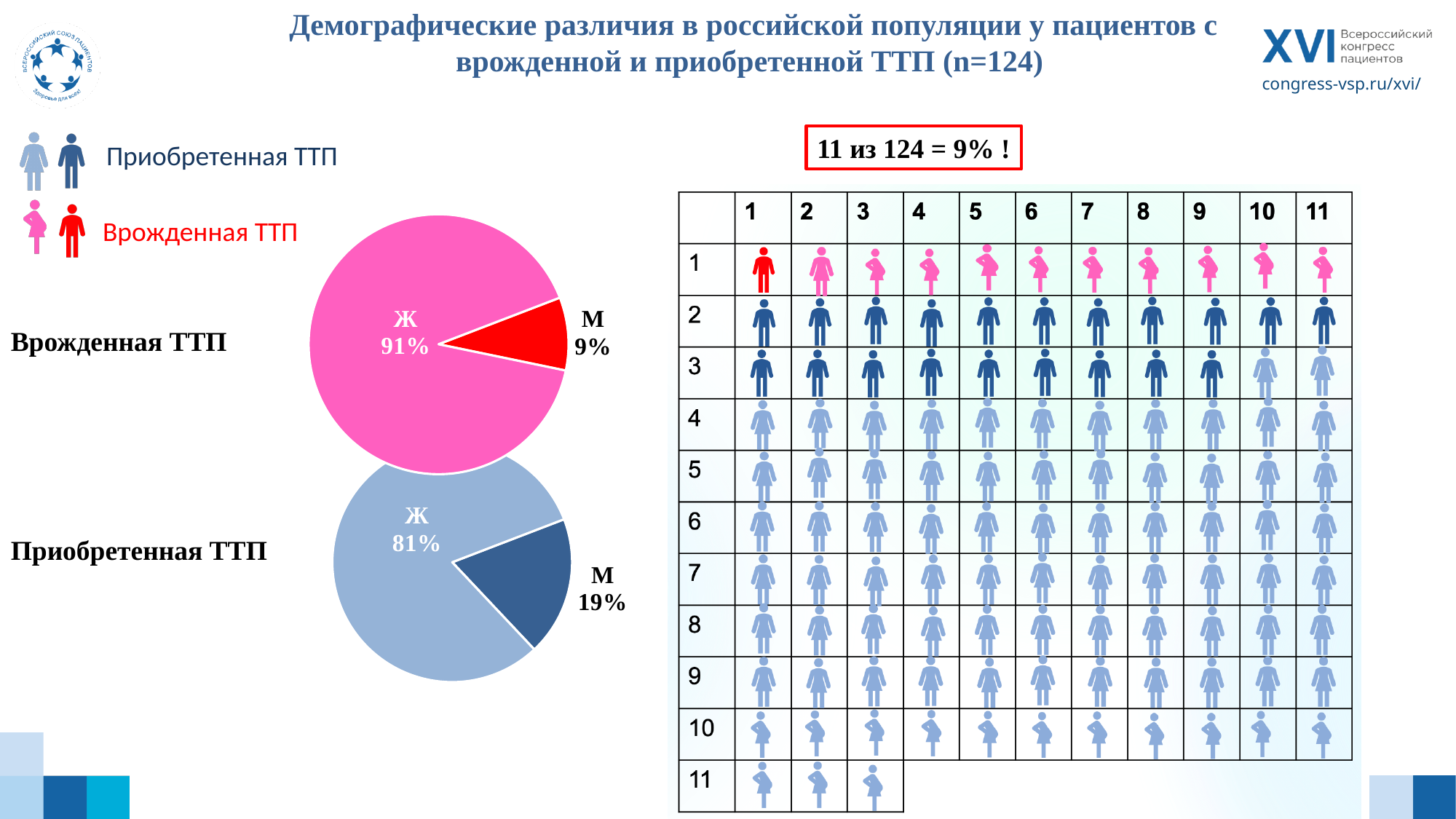
In the 'Приобретенная ТТП' pie chart, what share is labelled for Ж? 81% How many slices does the 'Врожденная ТТП' pie chart have? 2 In the 'Врожденная ТТП' pie chart, what share is labelled for Ж? 91% In the 'Приобретенная ТТП' pie chart, what is the difference between the Ж and М shares? 62% What figure is shown in the red box above the pictogram grid? 11 из 124 = 9% ! In the 'Приобретенная ТТП' pie chart, which slice is the smallest? М Which is larger: the М share in the 'Врожденная ТТП' pie chart or the М share in the 'Приобретенная ТТП' pie chart? Приобретенная ТТП In the 'Приобретенная ТТП' pie chart, what share is labelled for М? 19% In the 'Врожденная ТТП' pie chart, what share is labelled for М? 9% In the 'Врожденная ТТП' pie chart, which slice is the largest? Ж In the 'Врожденная ТТП' pie chart, what colour is the М slice? Red What type of chart is used for 'Врожденная ТТП' and 'Приобретенная ТТП'? Pie chart